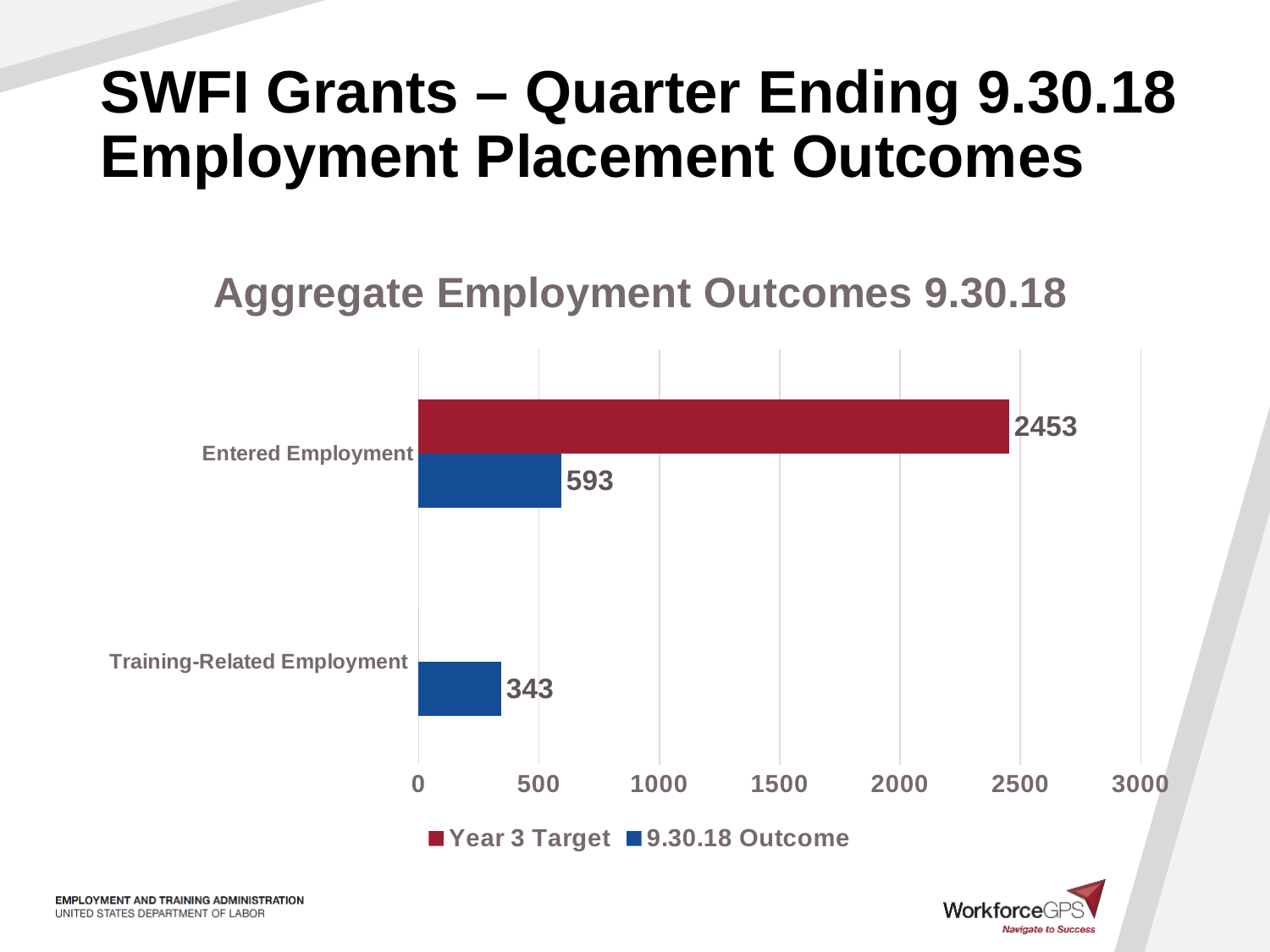
What is the title of the chart? Aggregate Employment Outcomes 9.30.18 What is the 9.30.18 Outcome value for Training-Related Employment? 343 What is the 9.30.18 Outcome value for Entered Employment? 593 What is the Year 3 Target value for Entered Employment? 2453 Which category has the highest 9.30.18 Outcome value? Entered Employment Is the Year 3 Target for Entered Employment greater or less than 2000? greater What kind of chart is shown on the slide? Bar chart How much higher is the 9.30.18 Outcome for Entered Employment than for Training-Related Employment? 250 What is the difference between the Year 3 Target and the 9.30.18 Outcome for Entered Employment? 1860 Which is larger for Entered Employment: the Year 3 Target or the 9.30.18 Outcome? Year 3 Target How many series does the legend list? 2 How many categories are shown on the chart? 2